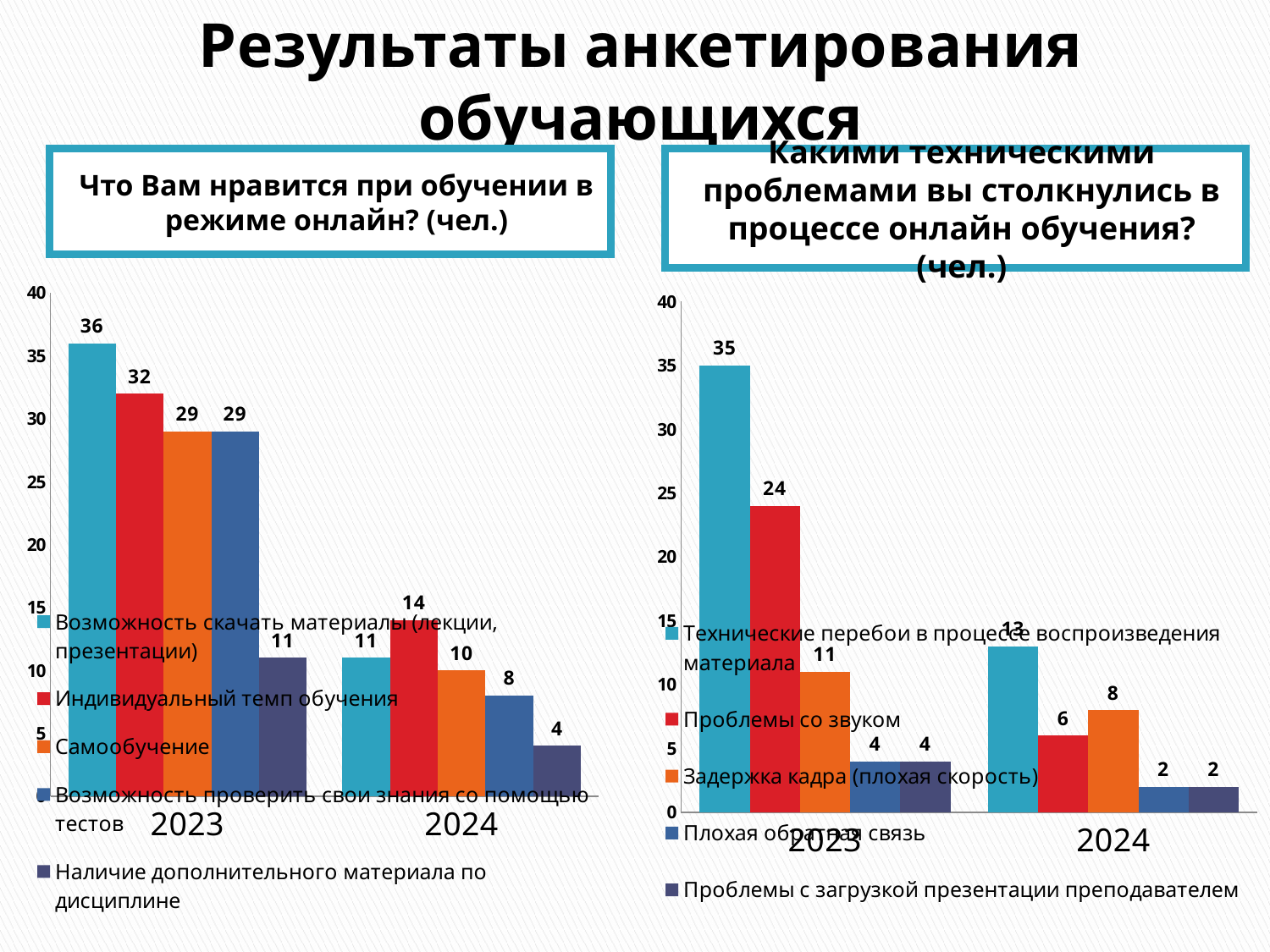
In the right chart, what is the difference between the 2023 and 2024 values for "Технические перебои в процессе воспроизведения материала"? 22 In the right chart, what is the value for "Задержка кадра (плохая скорость)" in 2024? 8 In the left chart, which series has the lowest value in 2024? Наличие дополнительного материала по дисциплине In the left chart, what is the value for "Индивидуальный темп обучения" in 2024? 14 What type of chart is the right chart? Bar chart In the left chart ("Что Вам нравится при обучении в режиме онлайн?"), what is the value for "Возможность скачать материалы (лекции, презентации)" in 2023? 36 In the right chart ("Какими техническими проблемами вы столкнулись..."), what is the value for "Проблемы со звуком" in 2023? 24 In the right chart, which series has the highest value in 2024? Технические перебои в процессе воспроизведения материала In the right chart, which is larger in 2024: "Проблемы со звуком" or "Задержка кадра (плохая скорость)"? Задержка кадра (плохая скорость) In the left chart, what is the difference between the 2023 and 2024 values for "Индивидуальный темп обучения"? 18 In the left chart, which series has the highest value in 2023? Возможность скачать материалы (лекции, презентации) How many series does the legend of the left chart list? 5